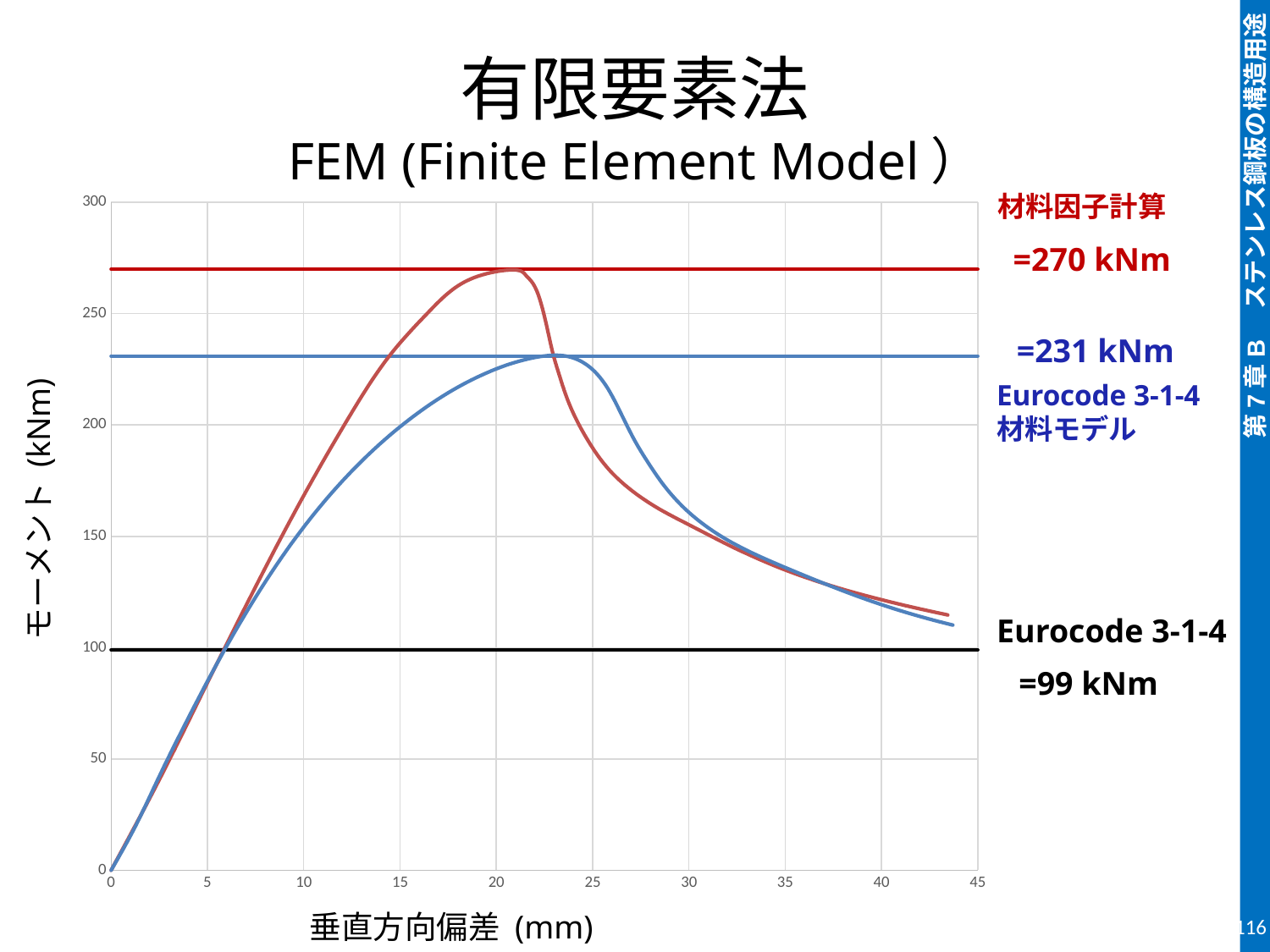
What kind of chart is shown on the slide? line chart What is the difference between the Eurocode 3-1-4 材料モデル value (231 kNm) and the Eurocode 3-1-4 value (99 kNm)? 132 kNm Which of the three horizontal reference lines has the lowest value? Eurocode 3-1-4 (99 kNm) What is the difference between the 材料因子計算 value (270 kNm) and the Eurocode 3-1-4 材料モデル value (231 kNm)? 39 kNm What is the value of the black horizontal line labelled Eurocode 3-1-4? 99 kNm Which of the three horizontal reference lines has the highest value? 材料因子計算 (270 kNm) What is the value of the horizontal line labelled Eurocode 3-1-4 材料モデル? 231 kNm What is the label of the vertical axis? モーメント (kNm) What is the label of the horizontal axis? 垂直方向偏差 (mm) Is the peak value of the blue curve greater or less than 200 kNm? greater What is the value of the horizontal line labelled 材料因子計算? 270 kNm Which curve reaches a higher peak moment, the red curve or the blue curve? the red curve